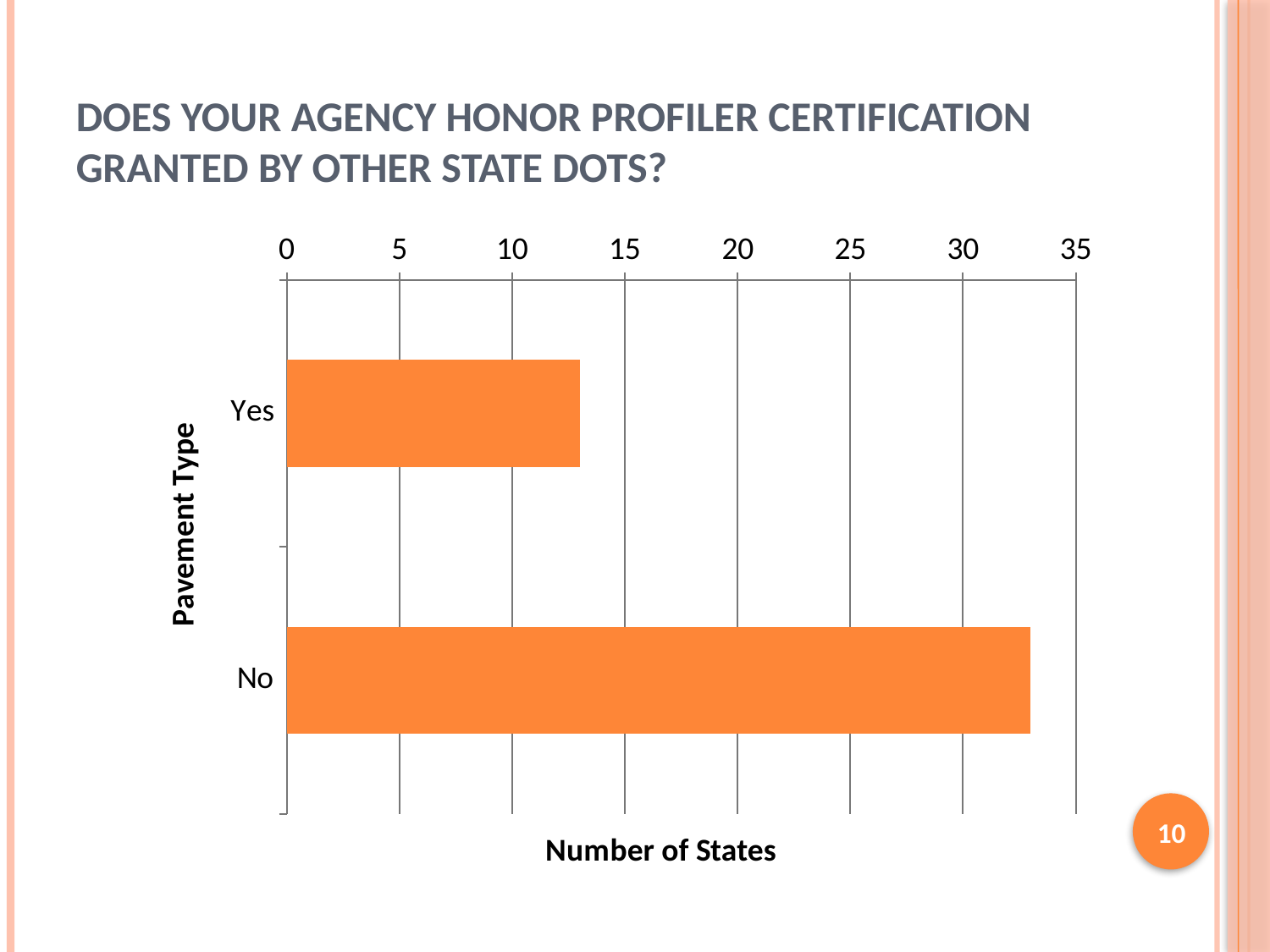
What kind of chart is shown on the slide? bar chart What is the label of the horizontal axis? Number of States What is the label of the vertical axis? Pavement Type Which category has the highest number of states? No Is the value for Yes greater or less than 15? less Is the value for No greater or less than 30? greater Which category has the lowest number of states? Yes Is the value for No greater or less than 35? less How many categories are plotted in the chart? 2 Which is larger, the number of states for Yes or for No? No